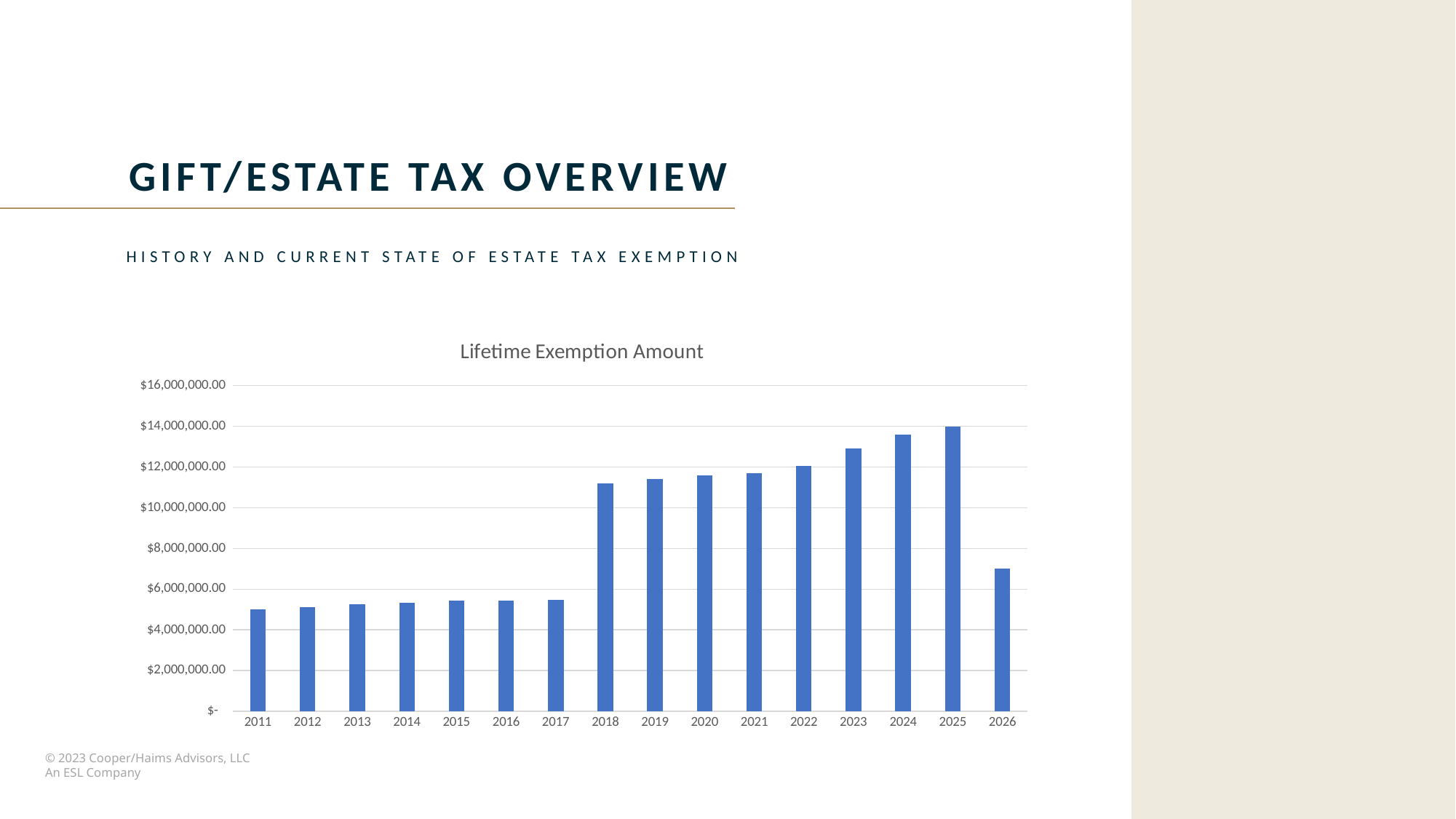
Do the values rise or fall from 2011 to 2025? rise Is the value for 2018 greater or less than $10,000,000.00? greater Is the value for 2024 greater or less than $12,000,000.00? greater Which year has the larger lifetime exemption amount, 2017 or 2018? 2018 How many years are shown on the x axis of the chart? 16 Is the value for 2026 greater or less than $8,000,000.00? less What type of chart is shown on the slide? Bar chart What is the title of the chart? Lifetime Exemption Amount Which year has the larger lifetime exemption amount, 2025 or 2026? 2025 Which year has the highest lifetime exemption amount? 2025